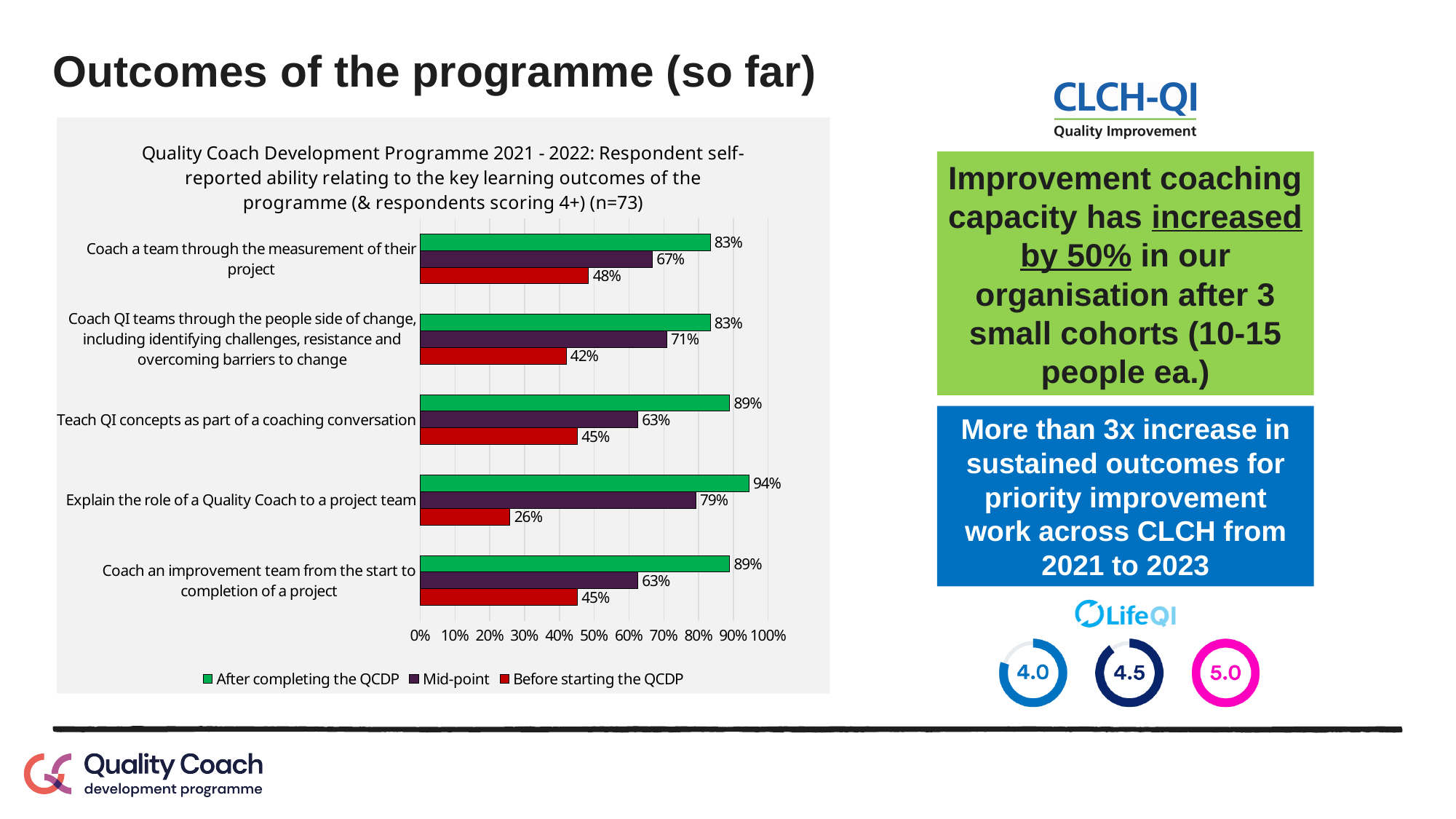
How many categories are shown on the chart? 5 What is the sample size (n) stated in the chart title? 73 What is the difference between the 'After completing the QCDP' and 'Before starting the QCDP' values for 'Explain the role of a Quality Coach to a project team'? 68% What is the 'Mid-point' value for 'Coach QI teams through the people side of change, including identifying challenges, resistance and overcoming barriers to change'? 71% Which category has the lowest 'Before starting the QCDP' value? Explain the role of a Quality Coach to a project team How many series does the legend list? 3 What is the 'Before starting the QCDP' value for 'Coach a team through the measurement of their project'? 48% What kind of chart is shown on the slide? Bar chart Which colour represents the 'Before starting the QCDP' series? Red What is the 'After completing the QCDP' value for 'Explain the role of a Quality Coach to a project team'? 94% Which is larger: the 'Mid-point' value for 'Teach QI concepts as part of a coaching conversation' or the 'Mid-point' value for 'Coach a team through the measurement of their project'? Coach a team through the measurement of their project Which category has the highest 'After completing the QCDP' value? Explain the role of a Quality Coach to a project team